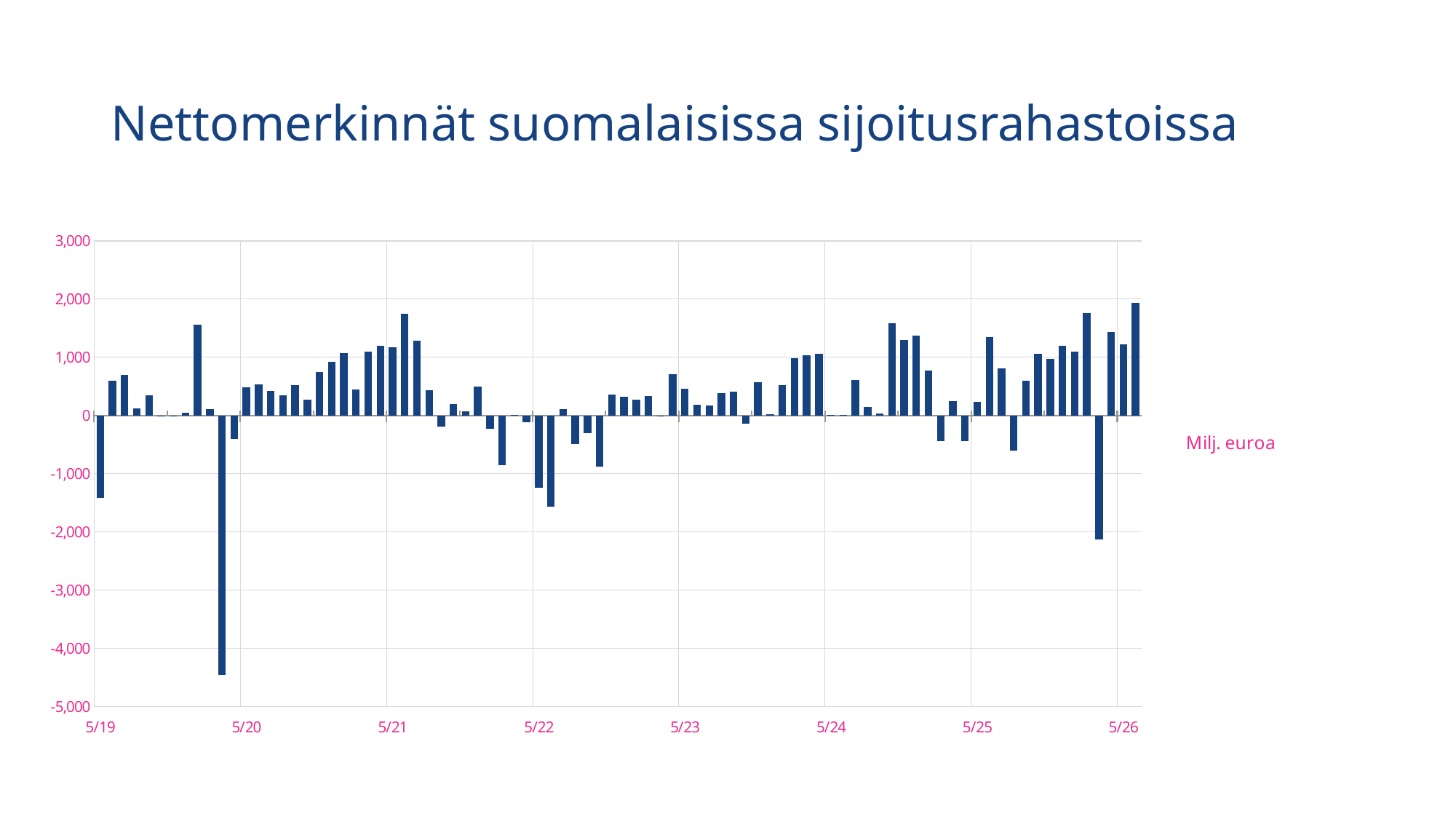
Is the value for 5/26 greater or less than 1,000? greater Is the lowest value on the chart greater or less than -4,000? less What unit label is shown next to the chart? Milj. euroa Is the value for 5/19 greater or less than -1,000? less How many date labels are shown on the x axis? 8 What is the title of the chart? Nettomerkinnät suomalaisissa sijoitusrahastoissa Which is larger, the value for 5/19 or the value for 5/26? 5/26 What kind of chart is shown on the slide? bar chart What is the lowest tick value shown on the y axis? -5,000